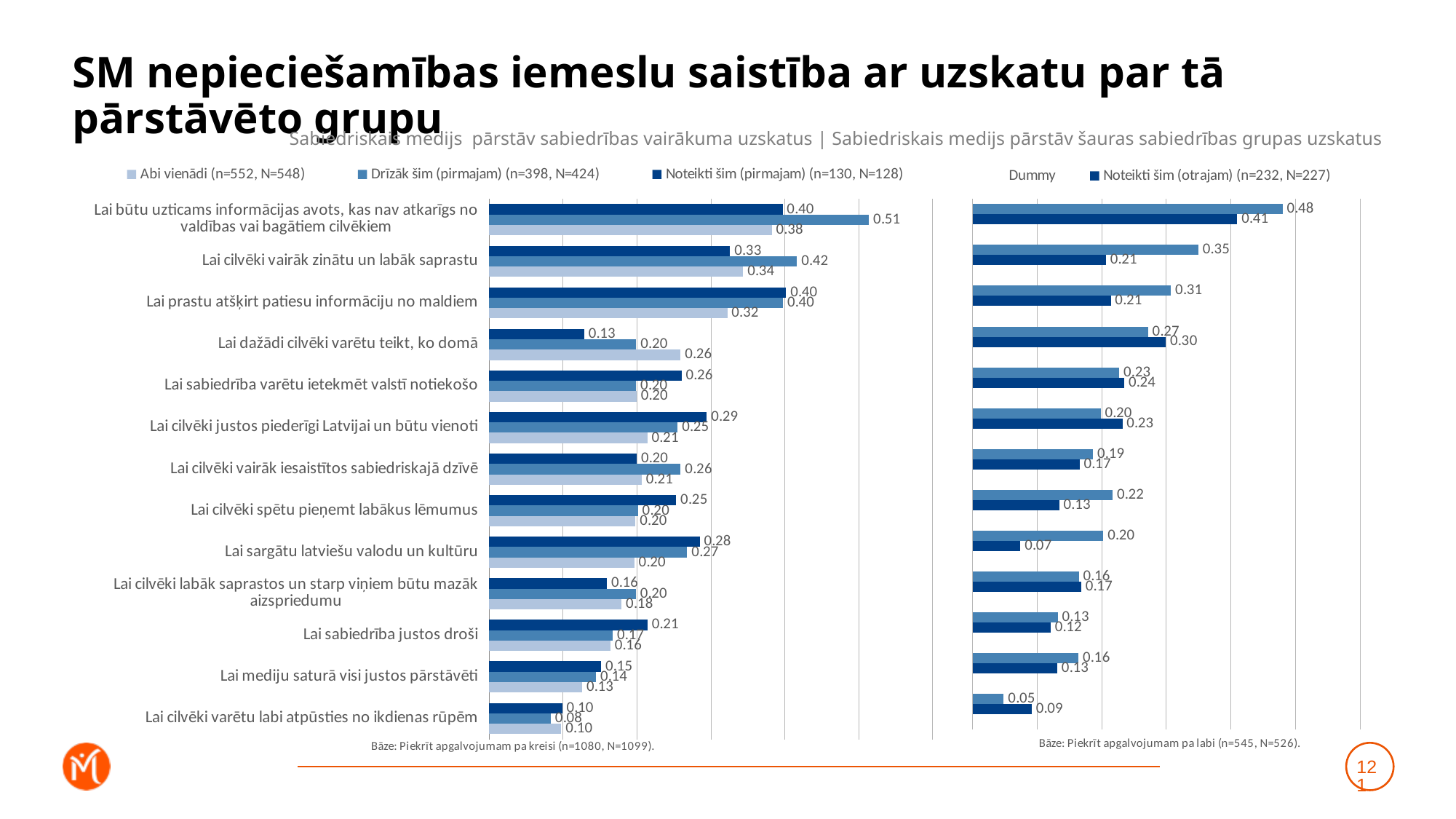
What is the value of the 'Noteikti šim (otrajam)' series for 'Lai sargātu latviešu valodu un kultūru' in the right panel? 0.07 Which category has the lowest value in the 'Abi vienādi' series? Lai cilvēki varētu labi atpūsties no ikdienas rūpēm For 'Lai būtu uzticams informācijas avots, kas nav atkarīgs no valdības vai bagātiem cilvēkiem', what is the difference between the 'Drīzāk šim (pirmajam)' value and the 'Abi vienādi' value? 0.13 What is the value of the 'Drīzāk šim (pirmajam)' series for 'Lai būtu uzticams informācijas avots, kas nav atkarīgs no valdības vai bagātiem cilvēkiem' in the left panel? 0.51 How many categories (statements) are listed on the chart? 13 How many entries does the legend list? 5 Which category has the highest value in the 'Noteikti šim (otrajam)' series in the right panel? Lai būtu uzticams informācijas avots, kas nav atkarīgs no valdības vai bagātiem cilvēkiem What kind of chart is shown on the slide? Bar chart According to the base note under the left panel, what are the n and N values? n=1080, N=1099 Which category has the highest value in the 'Drīzāk šim (pirmajam)' series? Lai būtu uzticams informācijas avots, kas nav atkarīgs no valdības vai bagātiem cilvēkiem What is the value of the 'Noteikti šim (pirmajam)' series for 'Lai sabiedrība justos droši'? 0.21 For 'Lai dažādi cilvēki varētu teikt, ko domā', which is larger: the 'Noteikti šim (pirmajam)' value or the 'Abi vienādi' value? Abi vienādi